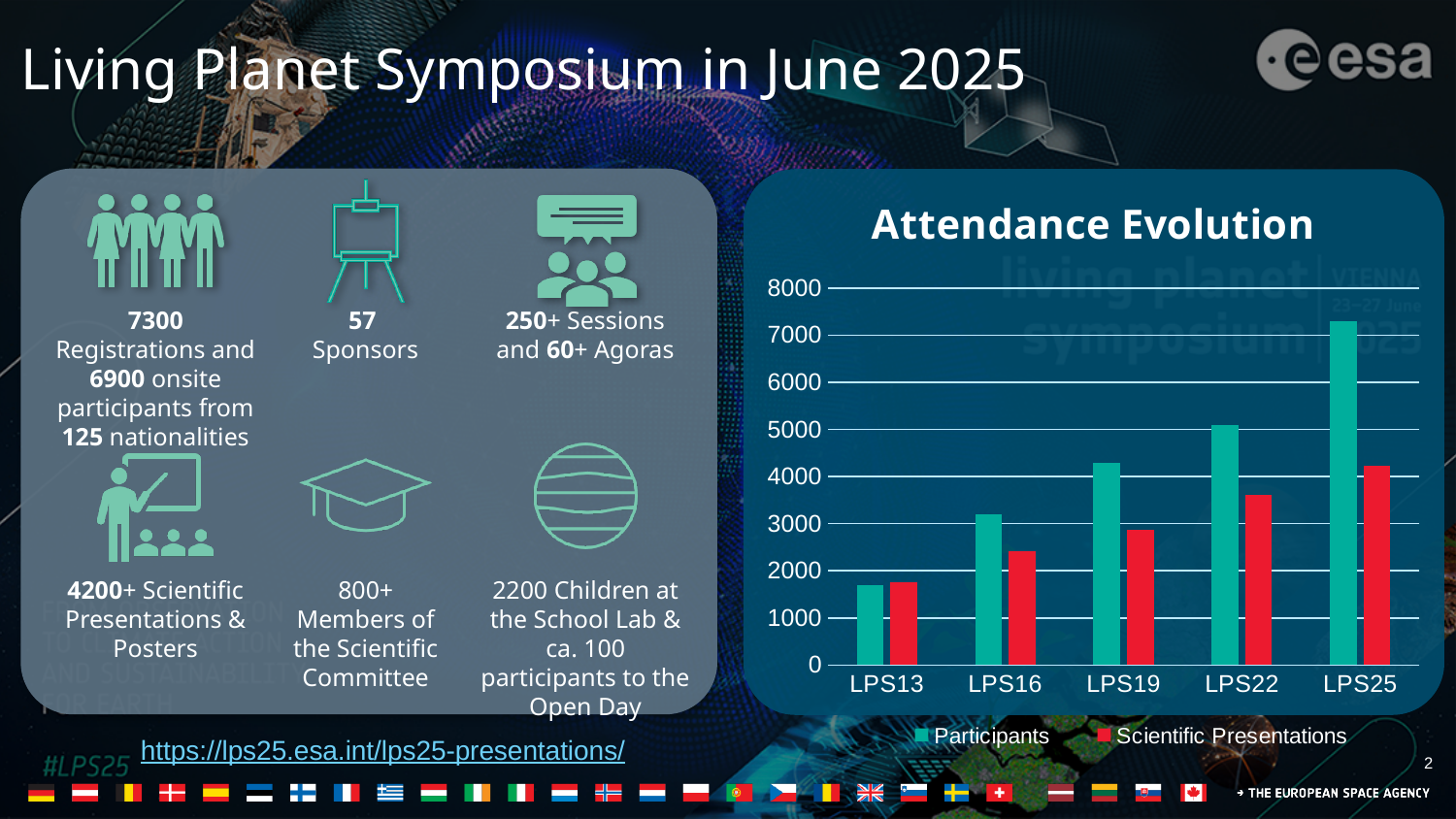
Which symposium edition has the highest number of Participants in the Attendance Evolution chart? LPS25 How many series does the legend of the Attendance Evolution chart list? 2 What type of chart is shown under the title "Attendance Evolution"? bar chart Which symposium edition has the lowest number of Participants in the Attendance Evolution chart? LPS13 Which colour represents Scientific Presentations in the Attendance Evolution chart? red Is the Participants value for LPS13 greater or less than 2000? less How many symposium editions (categories) are shown on the x axis of the Attendance Evolution chart? 5 Is the Scientific Presentations value for LPS16 greater or less than 3000? less Is the Scientific Presentations value for LPS22 greater or less than 3000? greater Do the Participants values rise or fall from LPS13 to LPS25 in the Attendance Evolution chart? rise In the Attendance Evolution chart, which is larger for LPS19: Participants or Scientific Presentations? Participants